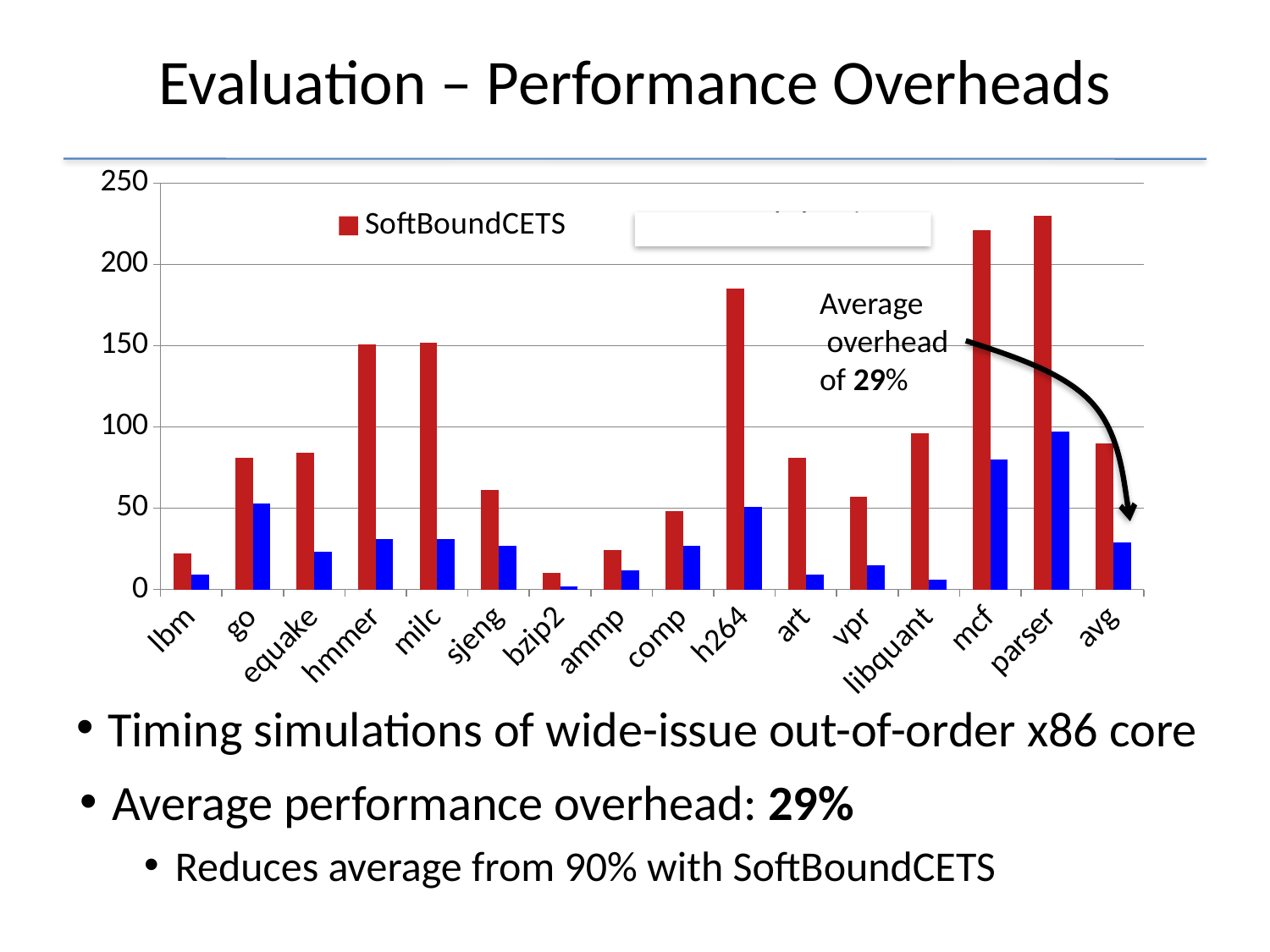
Is the SoftBoundCETS value for h264 larger or smaller than the SoftBoundCETS value for art? larger For mcf, which series has the larger value, SoftBoundCETS or the blue series? SoftBoundCETS How many series does the chart plot? 2 Is the SoftBoundCETS value for h264 greater or less than 150? greater What kind of chart is shown on the slide? bar chart Which category has the highest SoftBoundCETS value? parser Which category has the lowest SoftBoundCETS value? bzip2 Is the SoftBoundCETS value for lbm greater or less than 50? less Which category has the highest value for the blue series? parser Is the SoftBoundCETS value for mcf greater or less than 200? greater What colour are the SoftBoundCETS bars in the chart? red How many categories are shown along the x axis of the chart? 16